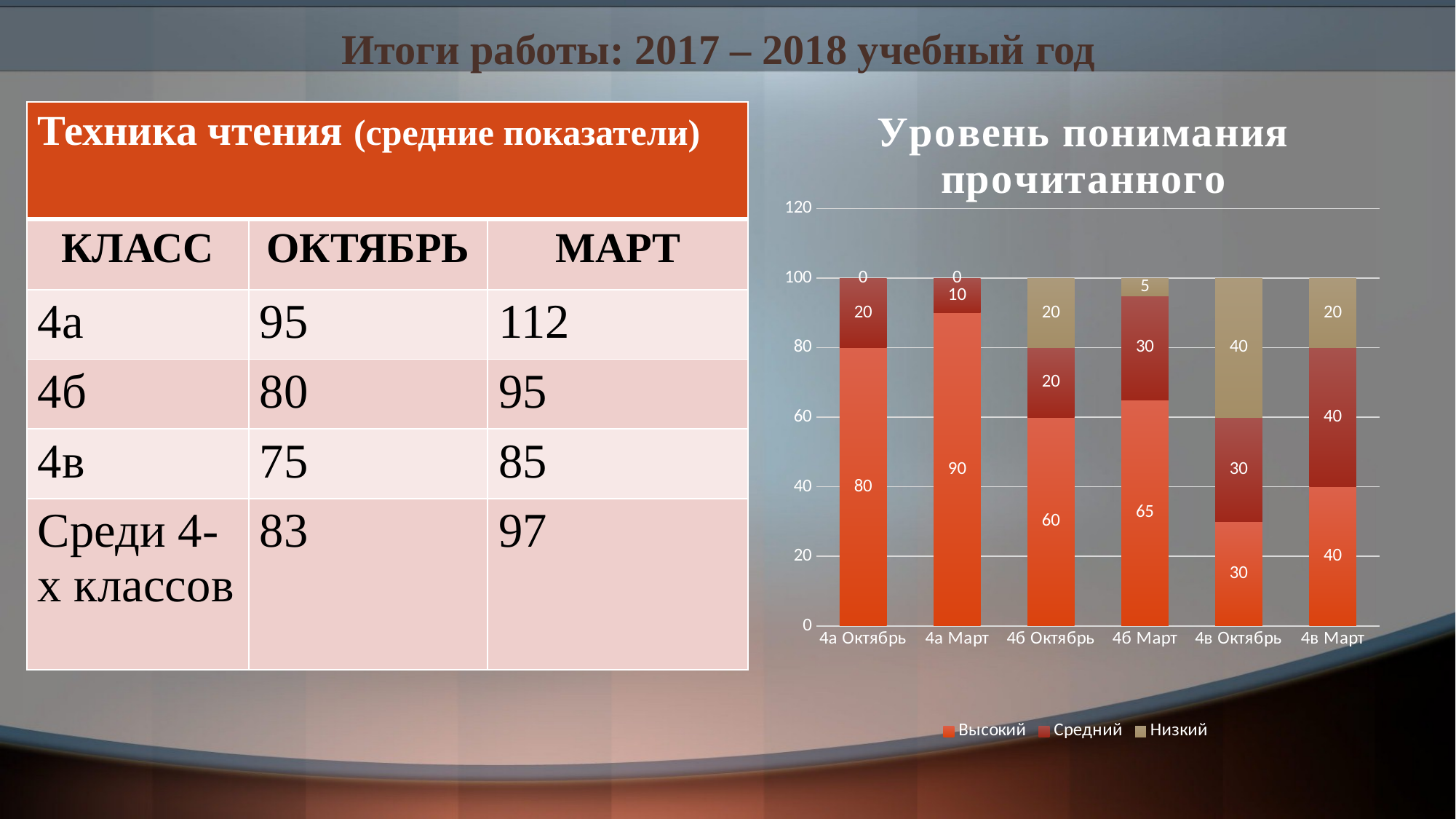
In the chart "Уровень понимания прочитанного", what is the difference between the Высокий values for 4а Март and 4а Октябрь? 10 How many categories are shown on the x axis of the chart "Уровень понимания прочитанного"? 6 In the chart "Уровень понимания прочитанного", which is larger: the Низкий value for 4б Октябрь or for 4б Март? 4б Октябрь In the chart "Уровень понимания прочитанного", what is the value of Высокий for 4а Октябрь? 80 In the chart "Уровень понимания прочитанного", which category has the lowest Высокий value? 4в Октябрь What are the legend entries of the chart "Уровень понимания прочитанного"? Высокий, Средний, Низкий In the chart "Уровень понимания прочитанного", what is the value of Низкий for 4в Октябрь? 40 In the chart "Уровень понимания прочитанного", which category has the highest Высокий value? 4а Март In the chart "Уровень понимания прочитанного", what is the value of Средний for 4б Март? 30 What kind of chart is "Уровень понимания прочитанного"? Stacked bar chart How many series does the legend of the chart "Уровень понимания прочитанного" list? 3 In the chart "Уровень понимания прочитанного", what is the total of the stacked bar for 4в Март? 100